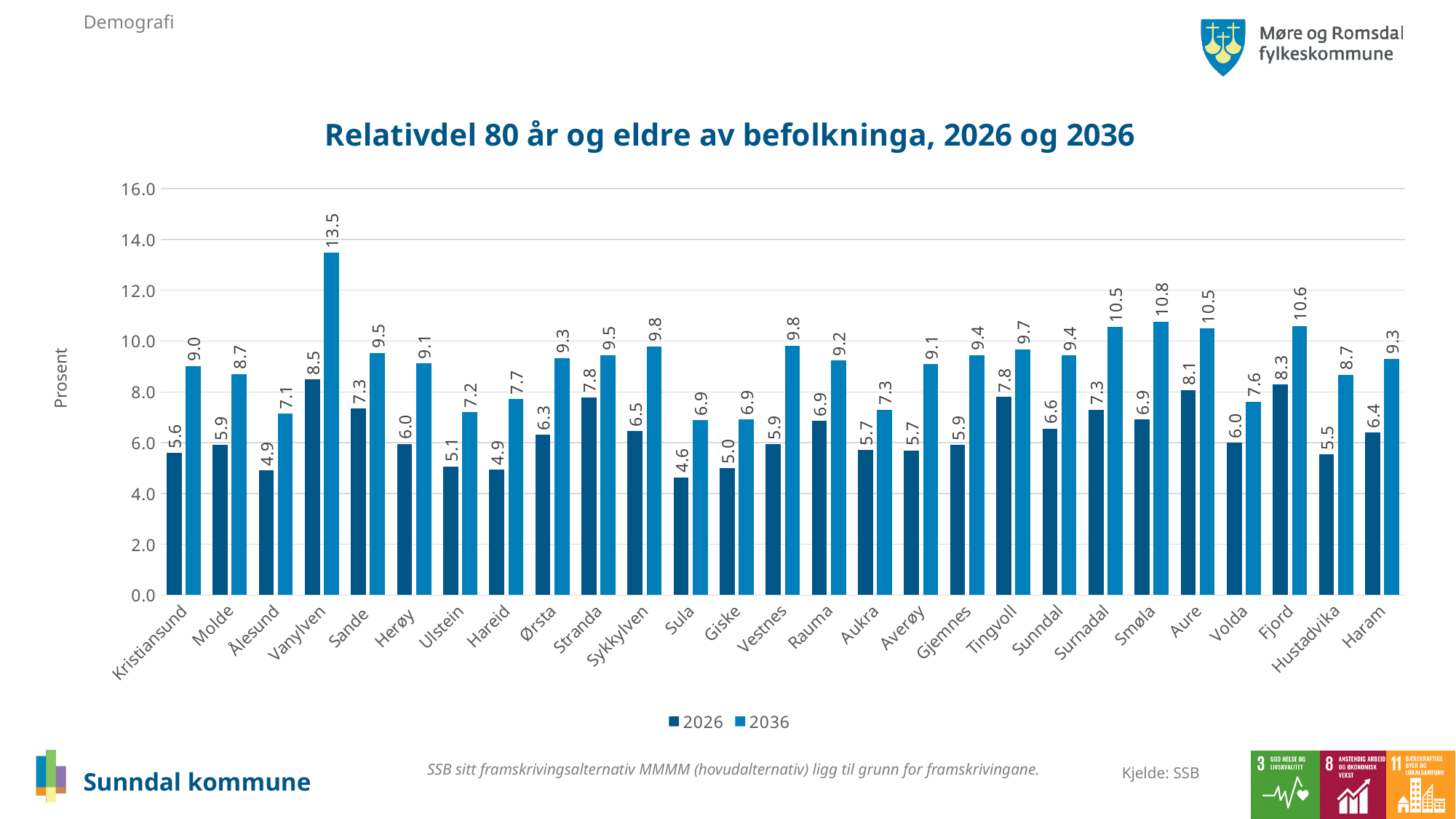
Is the 2036 value for Surnadal greater or less than 10.0? greater What is the difference between the 2036 and 2026 values for Sunndal? 2.8 How many series does the legend list? 2 What is the 2036 value for Smøla? 10.8 What is the 2026 value for Sunndal? 6.6 What kind of chart is shown? Bar chart Which municipality has the highest 2036 value? Vanylven Which is larger, the 2026 value for Fjord or the 2026 value for Aure? Fjord How many municipalities are shown on the x axis? 27 Which municipality has the lowest 2026 value? Sula What is the label on the y axis? Prosent What is the 2036 value for Vanylven? 13.5